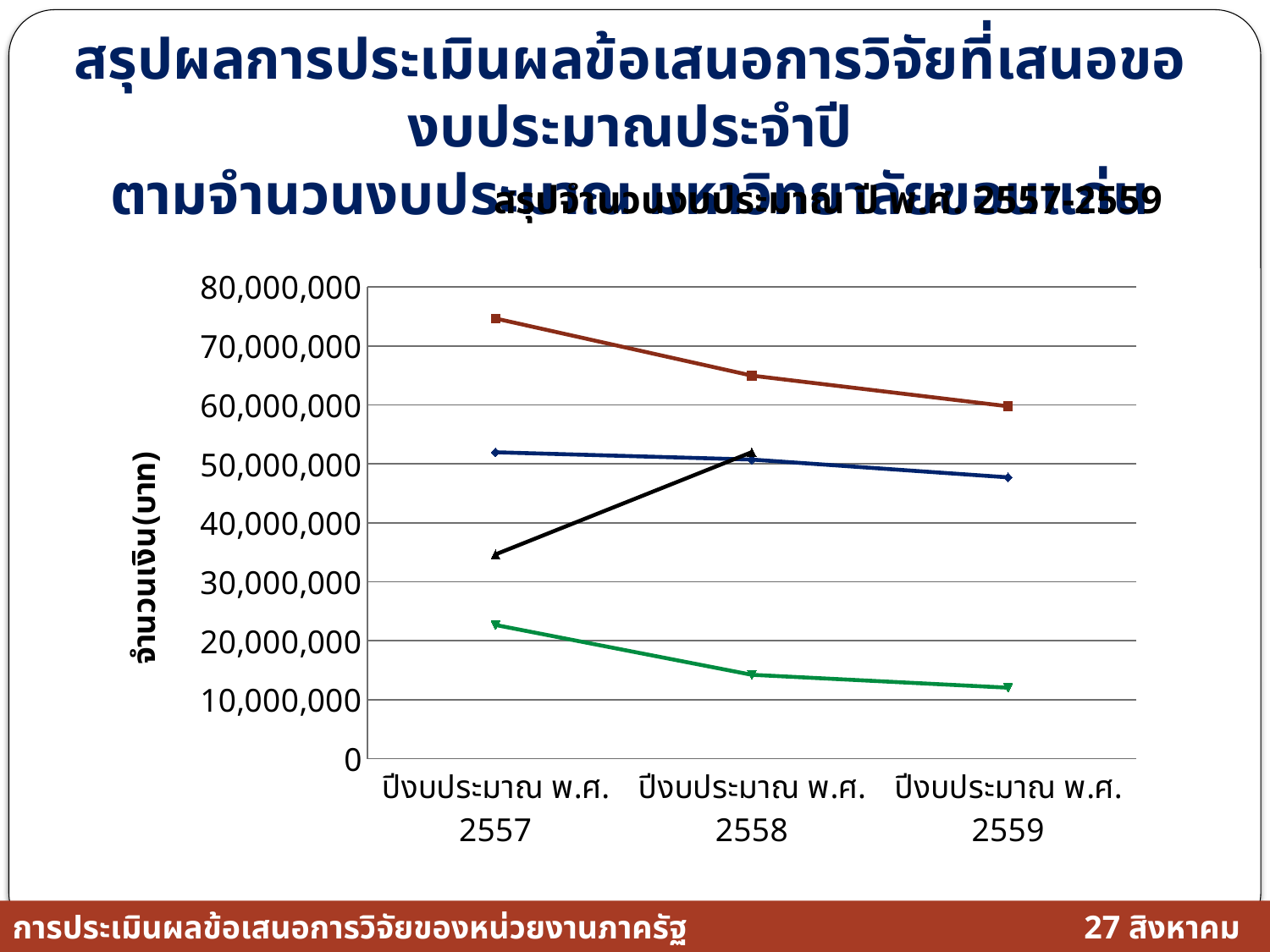
Does the red line rise or fall from ปีงบประมาณ พ.ศ. 2557 to ปีงบประมาณ พ.ศ. 2559? falls Does the black line rise or fall from ปีงบประมาณ พ.ศ. 2557 to ปีงบประมาณ พ.ศ. 2558? rises What kind of chart is shown on the slide? line chart What is the label of the y axis? จำนวนเงิน(บาท) Is the value of the red line for ปีงบประมาณ พ.ศ. 2557 greater or less than 70,000,000? greater Is the value of the green line for ปีงบประมาณ พ.ศ. 2559 greater or less than 20,000,000? less Which line has the lowest value for ปีงบประมาณ พ.ศ. 2557? the green line How many fiscal-year categories are shown on the x axis? 3 How many lines are plotted on the chart? 4 Which line has the highest value for ปีงบประมาณ พ.ศ. 2559? the red line Is the value of the black line for ปีงบประมาณ พ.ศ. 2557 greater or less than 40,000,000? less